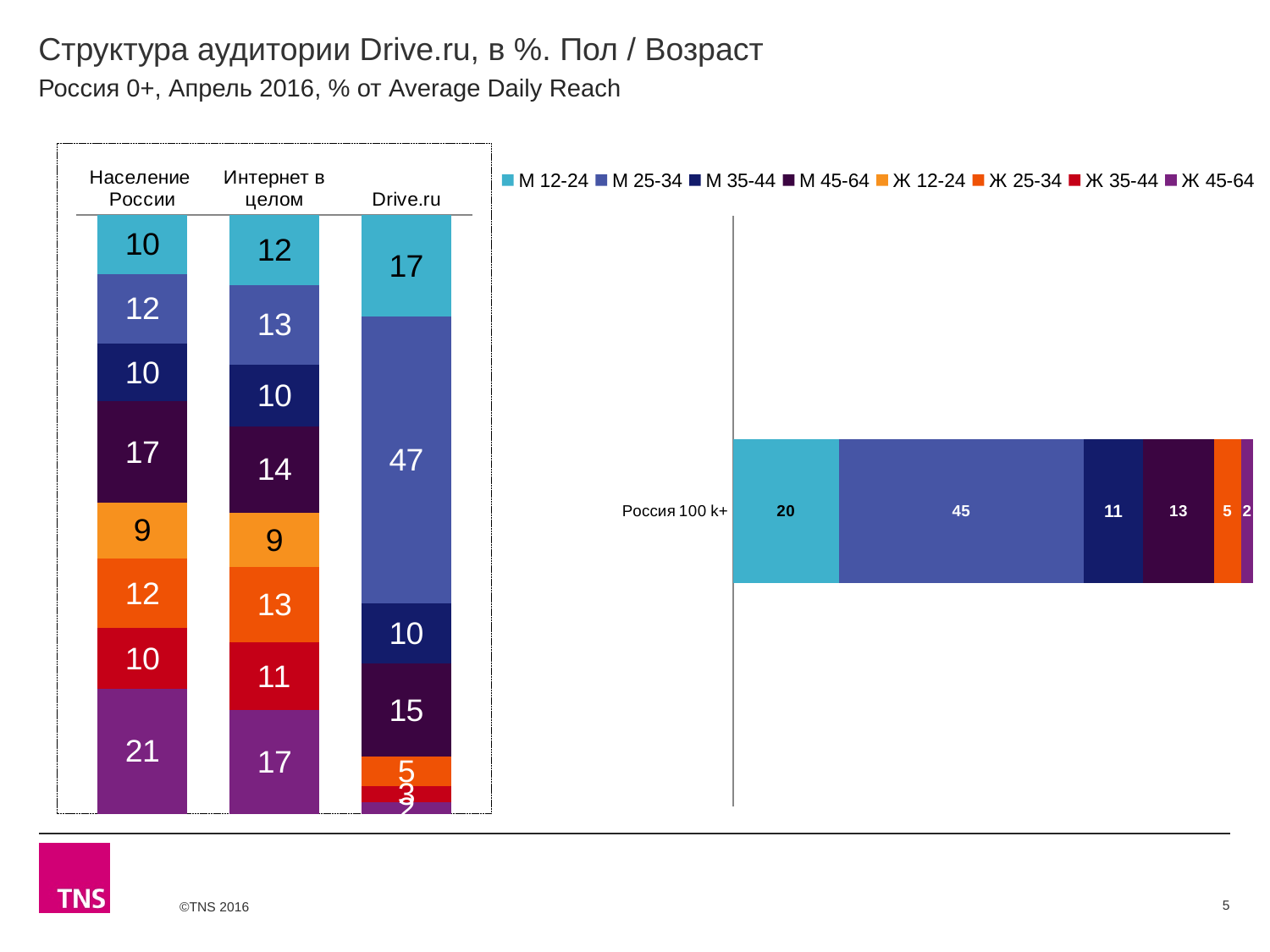
In the left chart, what is the value of the М 25-34 segment for Drive.ru? 47 What kind of chart is the left chart? Stacked bar chart In the right chart (Россия 100 k+), which series has the largest segment? М 25-34 In the left chart, what is the value of the М 45-64 segment for Население России? 17 In the left chart, which has the larger Ж 45-64 value: Население России or Интернет в целом? Население России In the right chart (Россия 100 k+), what is the value of the М 45-64 segment? 13 In the left chart, what is the value of the Ж 45-64 segment for Интернет в целом? 17 In the left chart, what is the difference between the М 25-34 value for Drive.ru and the М 25-34 value for Население России? 35 In the right chart (Россия 100 k+), what is the value of the М 12-24 segment? 20 How many series does the legend list? 8 How many bars (categories) are shown in the left chart? 3 In the right chart (Россия 100 k+), what is the value of the М 25-34 segment? 45